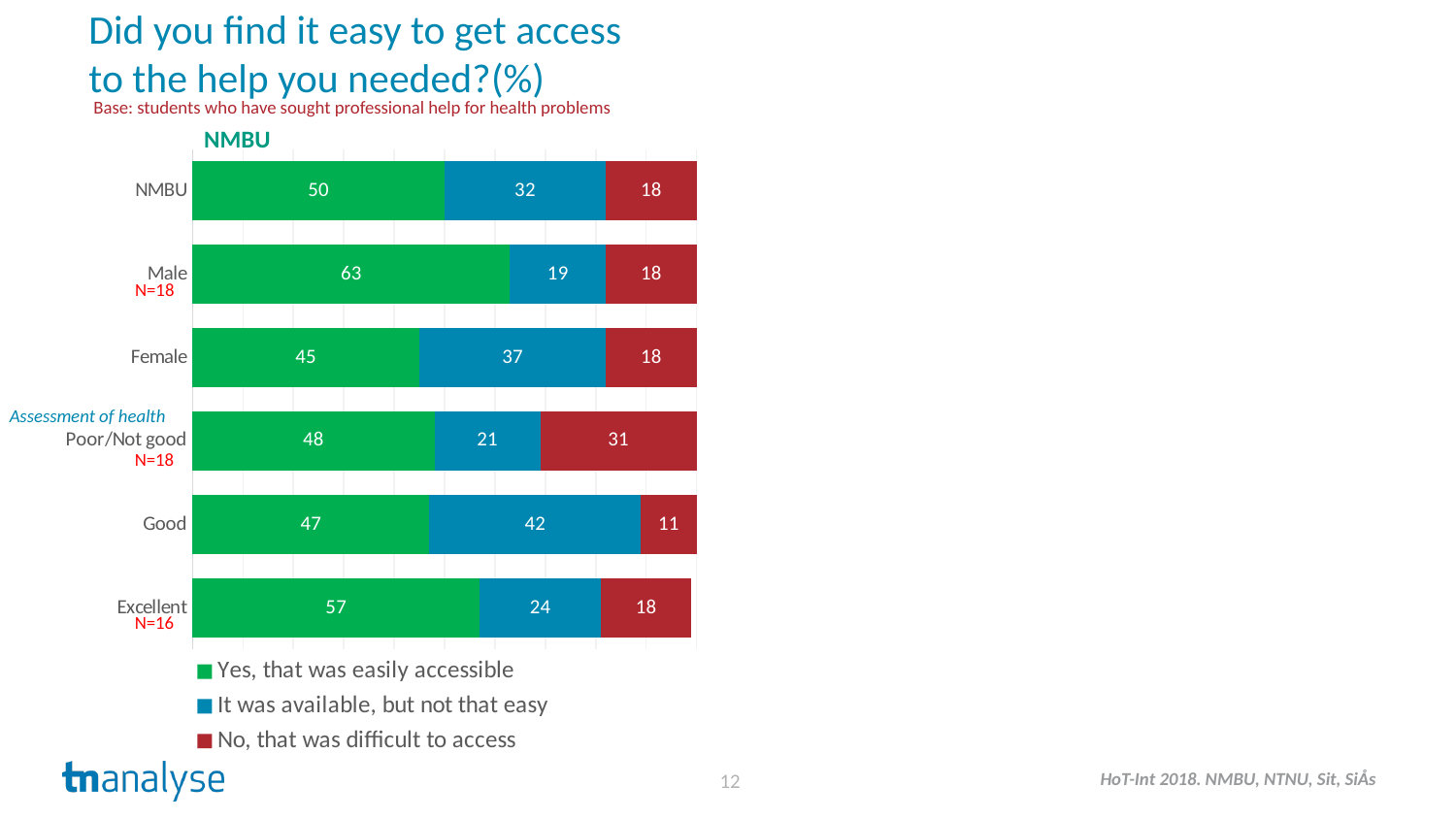
Which category has the highest value for 'Yes, that was easily accessible'? Male How many series does the legend list? 3 What is the value for 'No, that was difficult to access' in the Poor/Not good category? 31 What is the sample size (N) shown for the Excellent category? N=16 What kind of chart is shown on the slide? Stacked bar chart How many categories are shown on the chart? 6 What is the total of the stacked bar for the Excellent category? 99 Which is larger: the 'It was available, but not that easy' value for Female or for Excellent? Female Which category has the lowest value for 'No, that was difficult to access'? Good What is the difference between the 'Yes, that was easily accessible' values for Male and Female? 18 What is the value for 'It was available, but not that easy' in the Good category? 42 What percentage of Male respondents said 'Yes, that was easily accessible'? 63